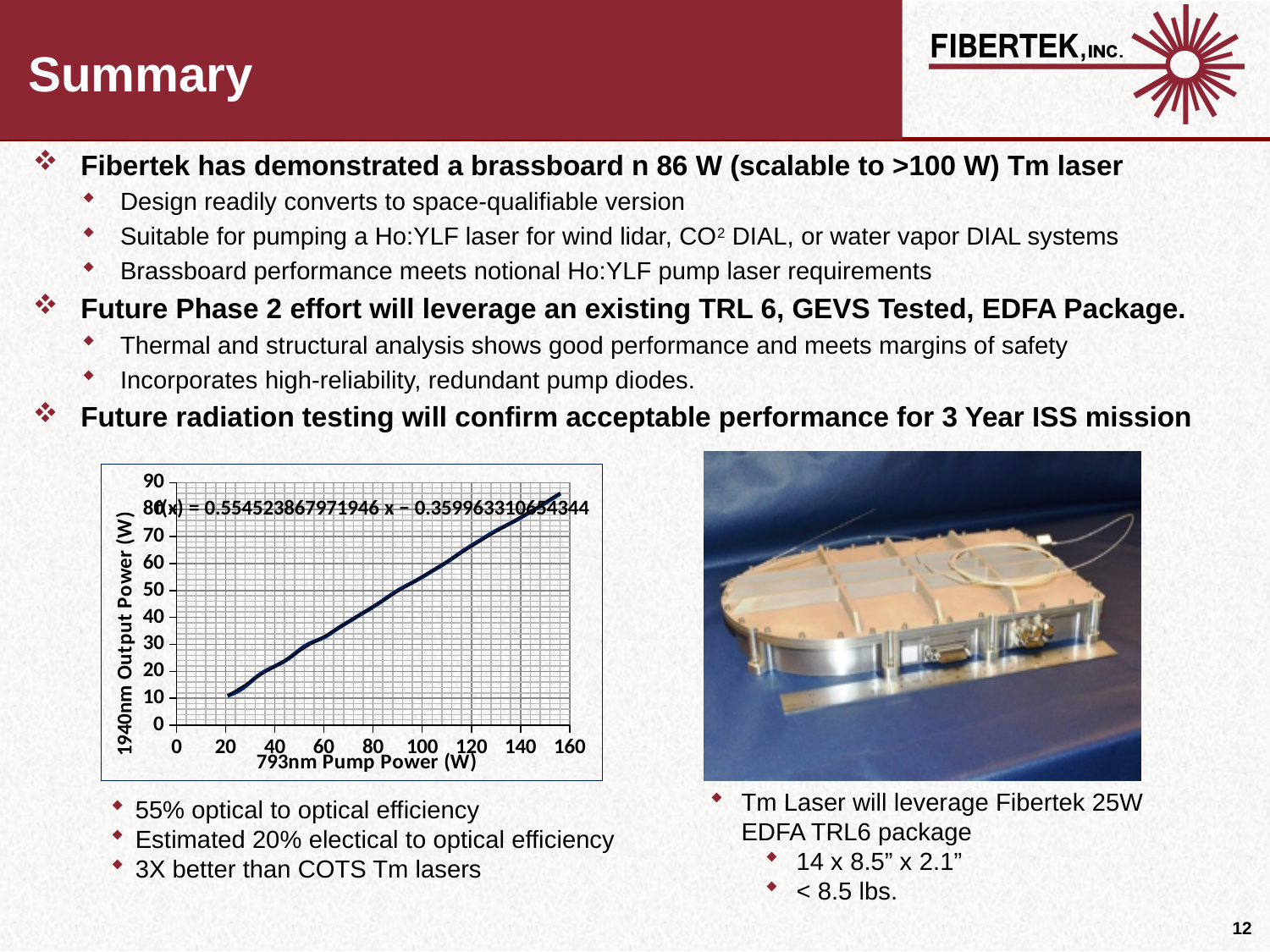
What is the label of the y axis of the chart? 1940nm Output Power (W) Does the 1940nm output power rise or fall as the 793nm pump power increases? rise Is the 1940nm output power at a pump power of 140 W greater or less than 70? greater What is the slope (coefficient of x) in the fitted equation printed on the chart? 0.554523867971946 Is the 1940nm output power at a pump power of 20 W greater or less than 20? less What is the highest tick value shown on the y axis of the chart? 90 What is the highest tick value shown on the x axis of the chart? 160 What kind of chart is shown on the slide? line chart What is the constant term in the fitted equation printed on the chart? − 0.359963310654344 Is the 1940nm output power at a pump power of 80 W greater or less than 50? less